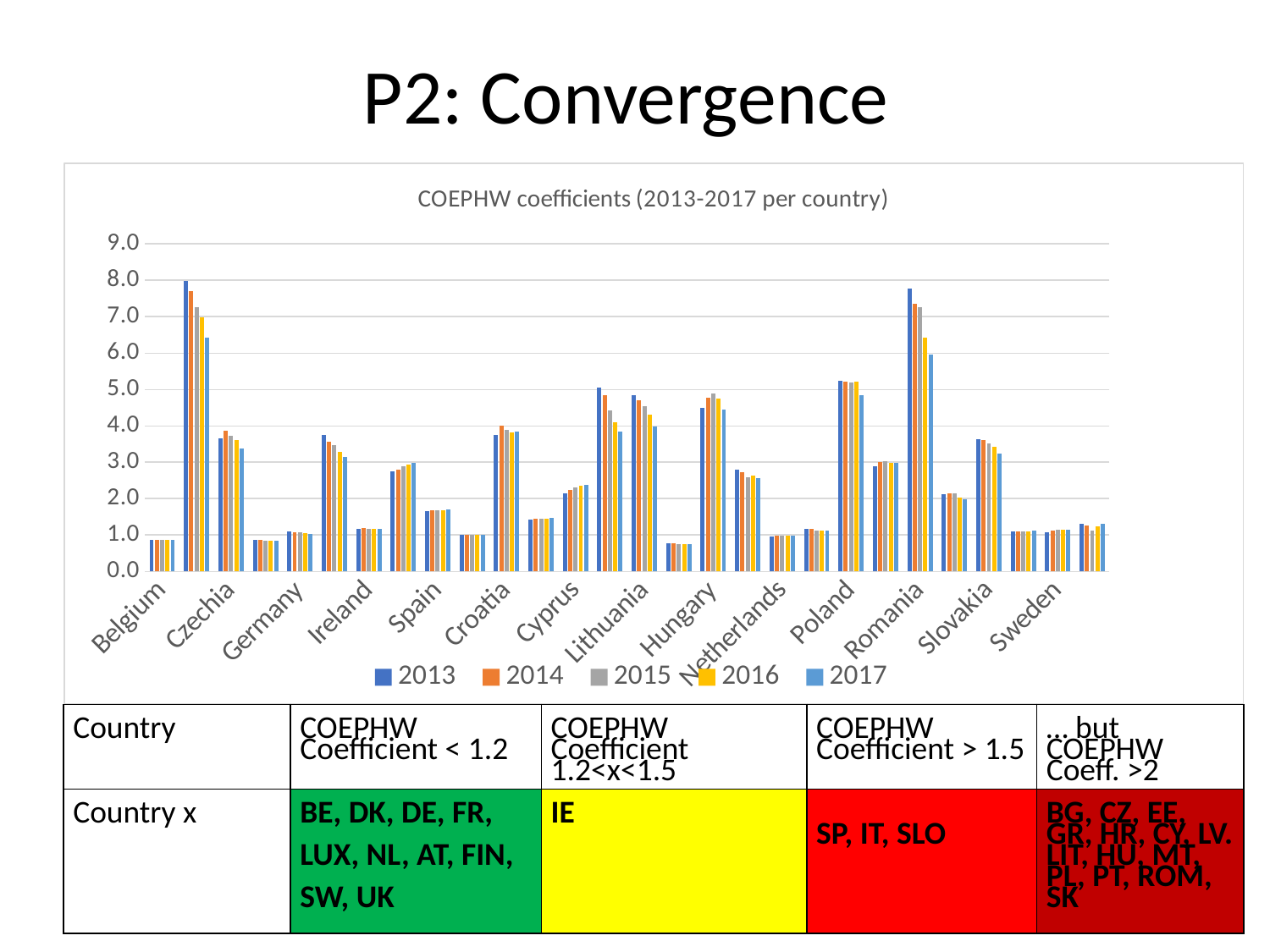
Do the bars for Czechia rise or fall from 2013 to 2017? fall Is the 2013 value for Czechia greater or less than 7.0? less Is the 2013 value for Germany greater or less than 2.0? less What kind of chart is shown on the slide? bar chart Which has the larger 2013 value, Czechia or Ireland? Czechia Is the 2013 value for Cyprus greater or less than 3.0? less What is the title of the chart? COEPHW coefficients (2013-2017 per country) Which years are listed in the chart's legend? 2013, 2014, 2015, 2016, 2017 How many series does the legend of the chart list? 5